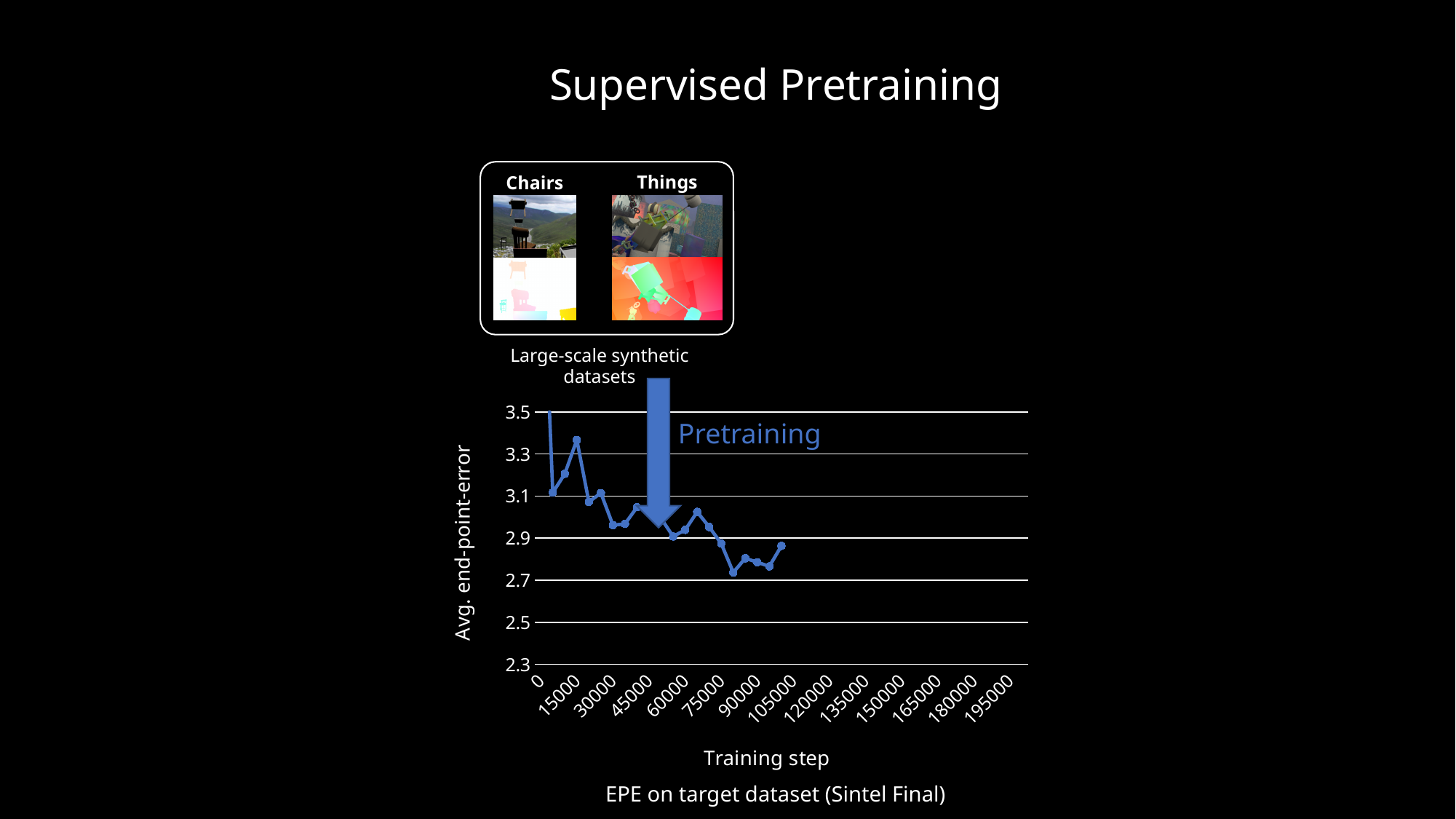
At which training step is the average end-point-error highest? 0 Is the value at training step 0 greater or less than 3.3? greater Is the value at training step 90000 greater or less than 2.9? less What kind of chart is shown on the slide? line chart Is the value at training step 15000 greater or less than 3.3? greater What is the label of the x axis? Training step What is the label of the y axis? Avg. end-point-error Which is larger, the value at training step 0 or the value at training step 90000? training step 0 Overall, does the average end-point-error rise or fall as the training step increases? fall